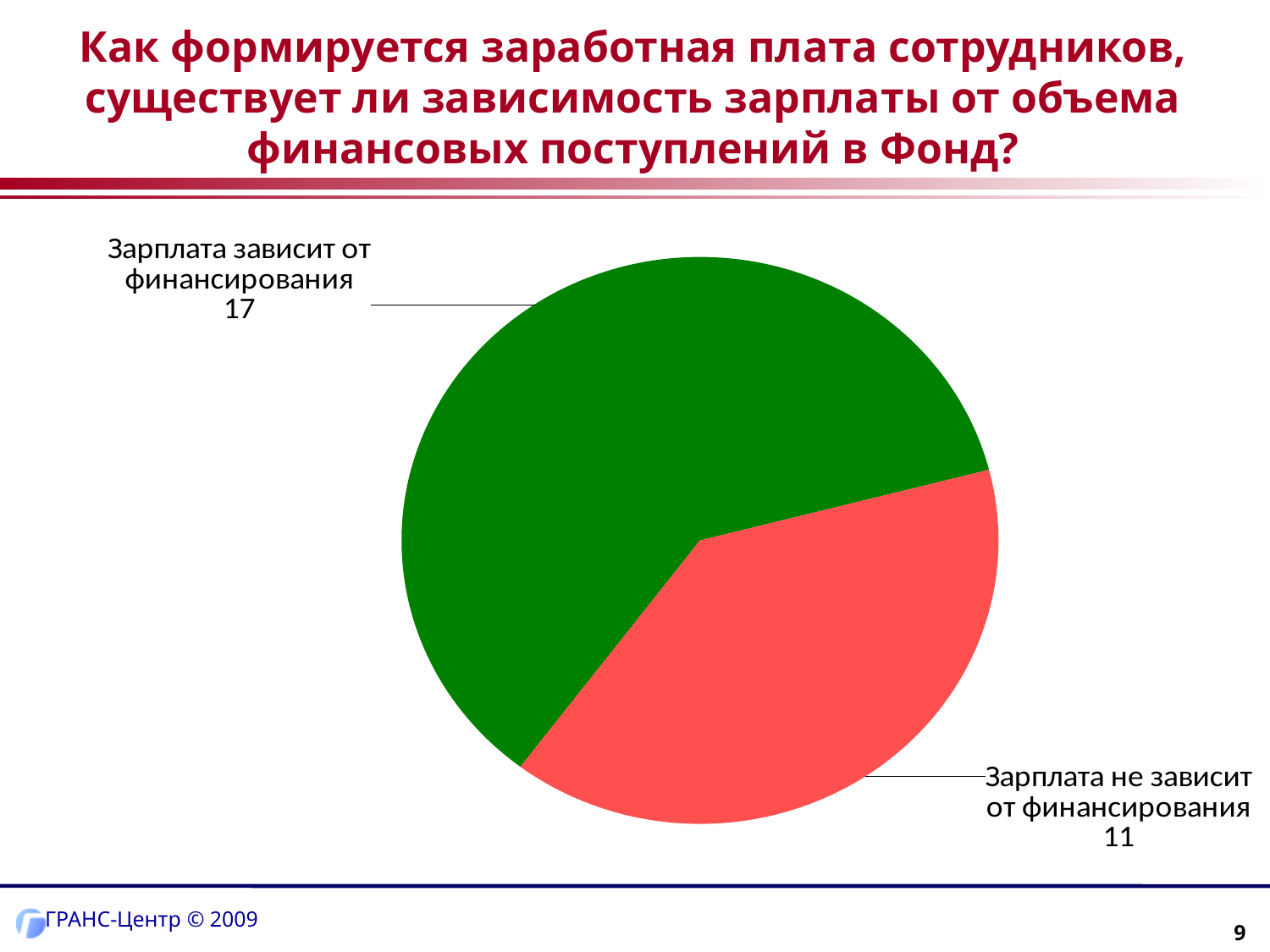
What type of chart is shown on the slide? pie chart What is the value for "Зарплата не зависит от финансирования"? 11 How many slices does the pie chart have? 2 Which is larger: "Зарплата зависит от финансирования" or "Зарплата не зависит от финансирования"? Зарплата зависит от финансирования What is the difference between the values for "Зарплата зависит от финансирования" and "Зарплата не зависит от финансирования"? 6 What is the value for "Зарплата зависит от финансирования"? 17 What colour is the slice for "Зарплата не зависит от финансирования"? red What colour is the slice for "Зарплата зависит от финансирования"? green Which category has the smallest slice of the pie? Зарплата не зависит от финансирования Which category has the largest slice of the pie? Зарплата зависит от финансирования What is the total of all slices in the pie chart? 28